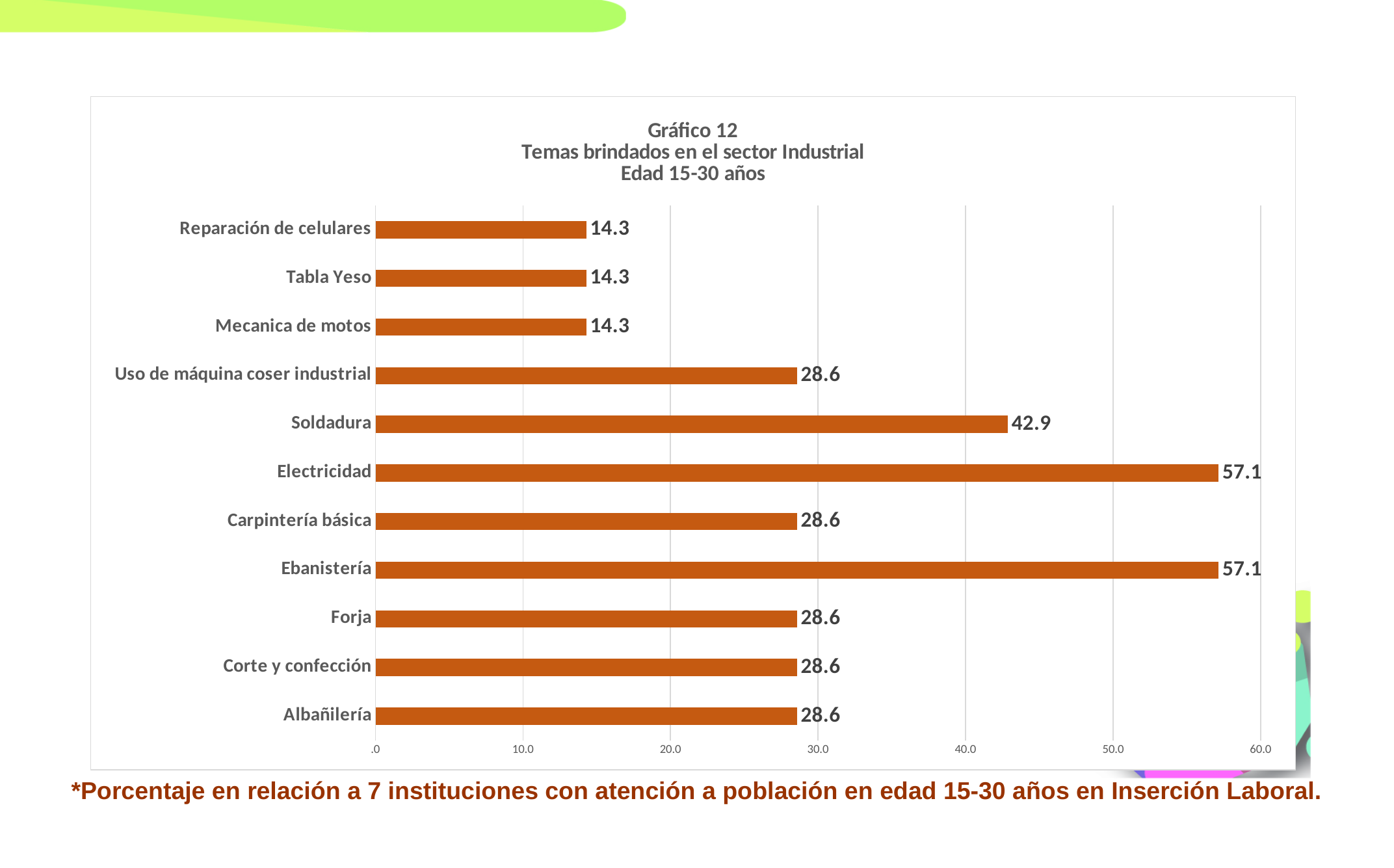
What kind of chart is shown on the slide? bar chart How many categories are shown in the chart? 11 Which is larger, the value for Soldadura or the value for Carpintería básica? Soldadura What is the title of the chart? Gráfico 12 Temas brindados en el sector Industrial Edad 15-30 años What is the highest value shown on the x axis? 60.0 What is the value for Tabla Yeso? 14.3 Is the value for Soldadura greater or less than 40.0? greater What is the difference between the values for Forja and Mecanica de motos? 14.3 What is the value for Soldadura? 42.9 What is the value for Electricidad? 57.1 What is the difference between the values for Electricidad and Soldadura? 14.2 What is the value for Albañilería? 28.6